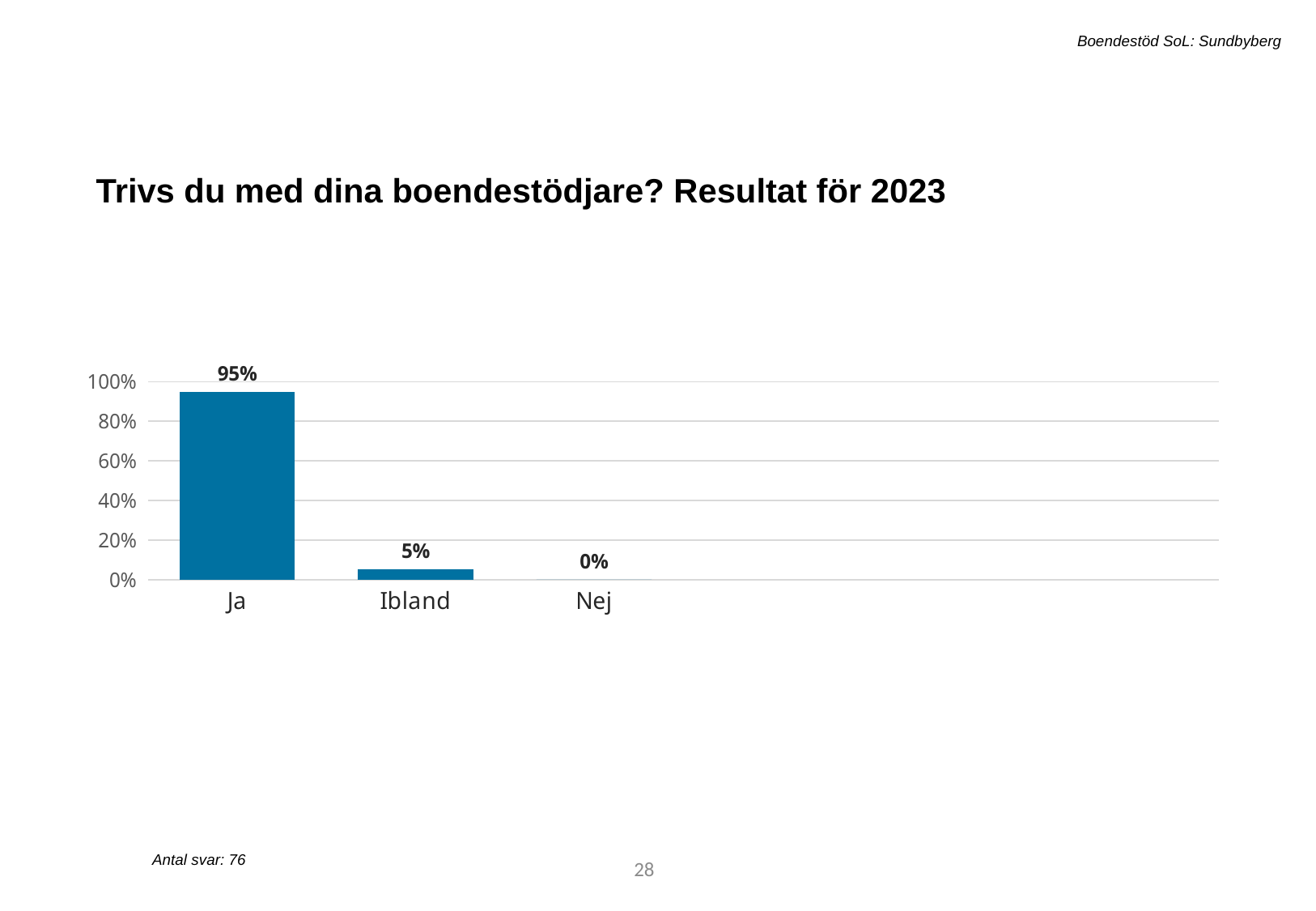
What kind of chart is shown on the slide? bar chart Do the values rise or fall from left to right along the x axis? fall What is the value for Ja? 95% What is the title of the slide containing the chart? Trivs du med dina boendestödjare? Resultat för 2023 Is the value for Ja greater or less than 80%? greater Which is larger, the value for Ibland or the value for Nej? Ibland What is the difference between the values for Ja and Ibland? 90% How many categories are shown on the x axis? 3 Which category has the lowest value? Nej What is the value for Ibland? 5% What is the value for Nej? 0% Which category has the highest value? Ja